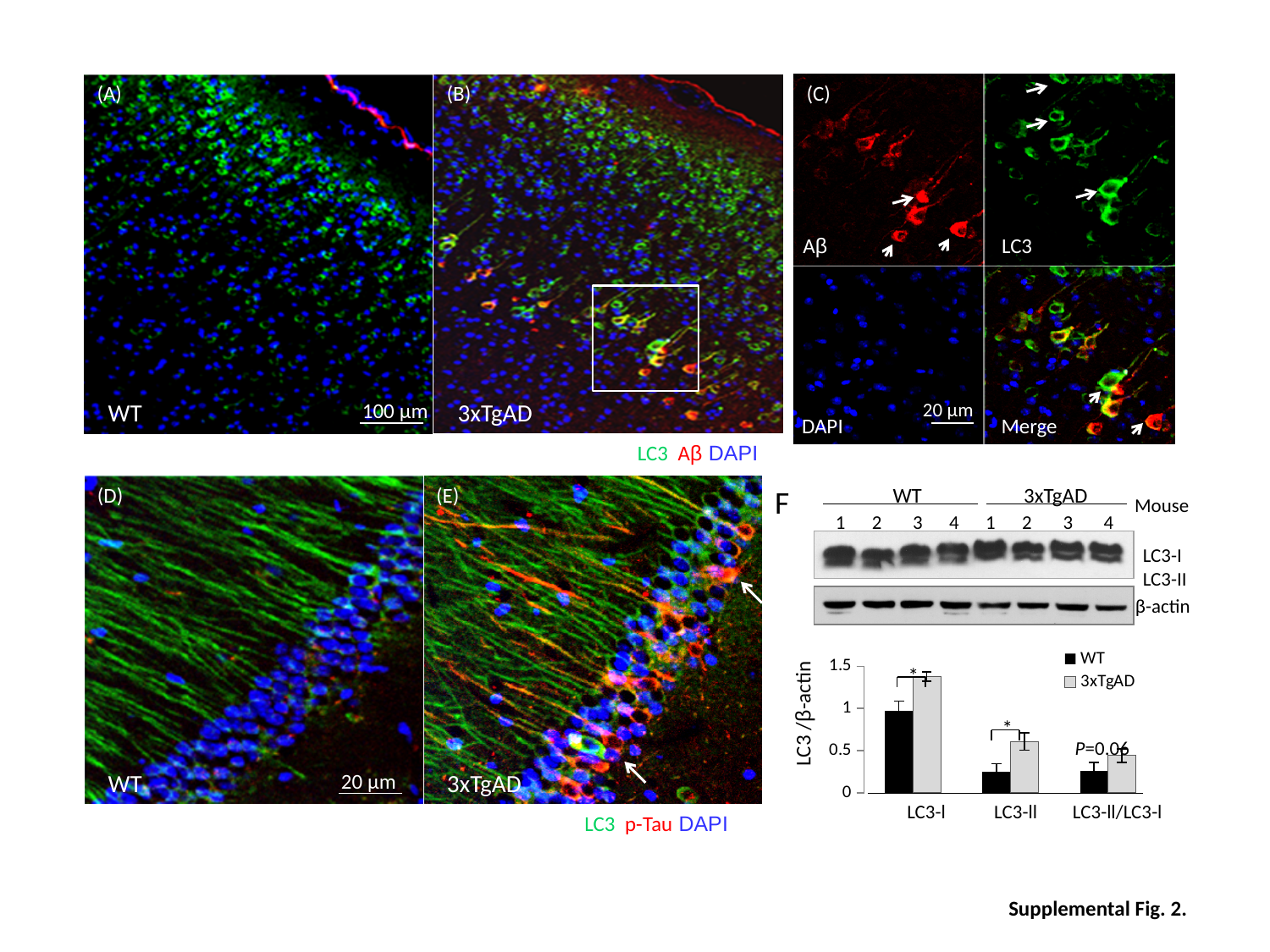
In the bar chart in panel F, is the 3xTgAD value for LC3-II greater or less than 0.5? greater In the bar chart in panel F, which category has the highest WT bar? LC3-I In the bar chart in panel F, is the WT value for LC3-II greater or less than 0.5? less What P value is printed above the LC3-II/LC3-I bars in the bar chart in panel F? P=0.06 In the bar chart in panel F, which series is larger for LC3-II, WT or 3xTgAD? 3xTgAD What kind of chart is shown in panel F of the slide? bar chart In the bar chart in panel F, which category has the highest 3xTgAD bar? LC3-I In the bar chart in panel F, which series is larger for LC3-I, WT or 3xTgAD? 3xTgAD How many series does the legend of the bar chart in panel F list? 2 In the bar chart in panel F, is the 3xTgAD value for LC3-I greater or less than 1? greater How many categories are shown on the x axis of the bar chart in panel F? 3 What is the y-axis label of the bar chart in panel F? LC3/β-actin